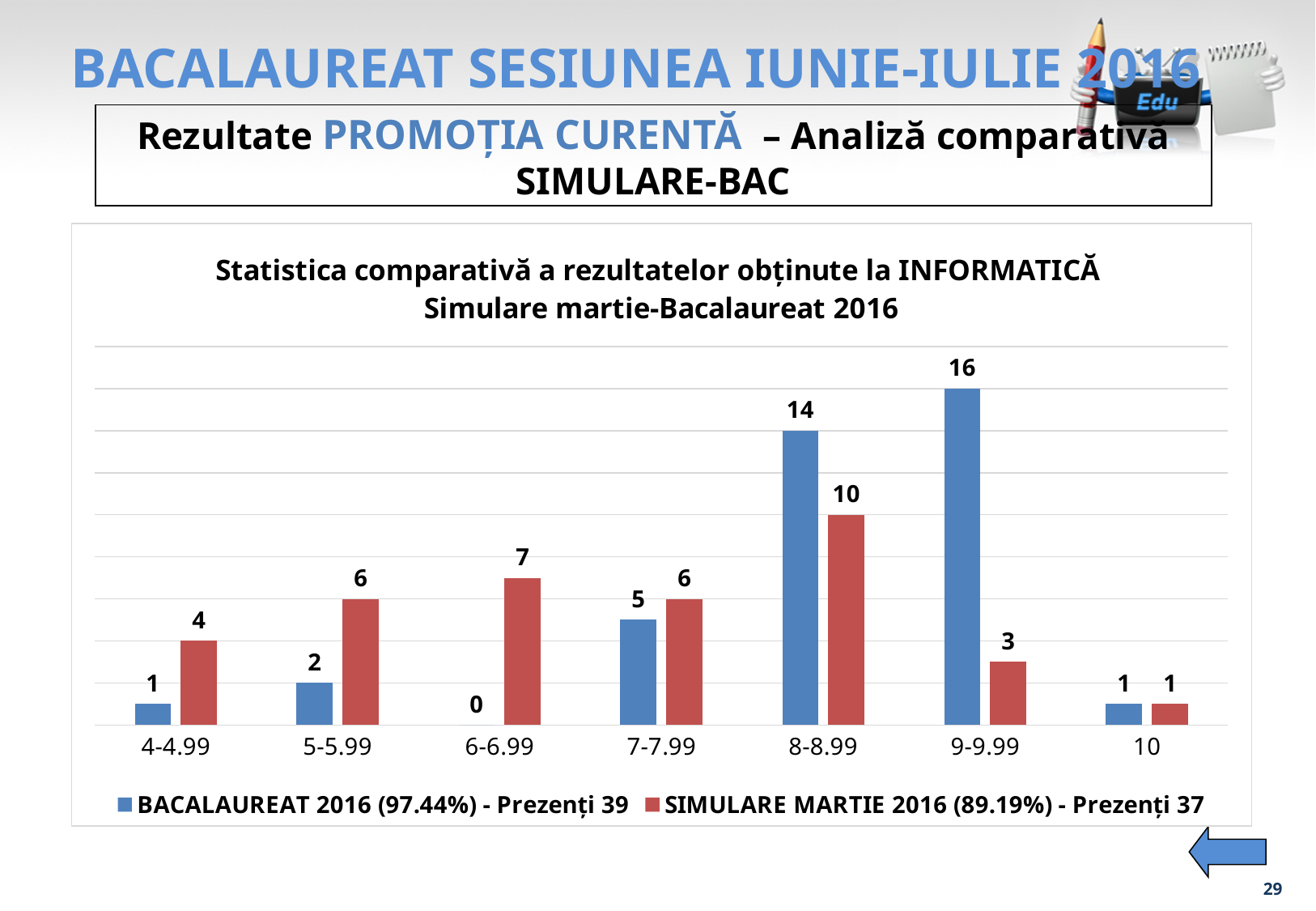
What is the value for SIMULARE MARTIE 2016 in the 10 category? 1 Which category has the highest value for BACALAUREAT 2016? 9-9.99 What is the value for BACALAUREAT 2016 in the 8-8.99 category? 14 What is the value for BACALAUREAT 2016 in the 6-6.99 category? 0 What is the difference between the BACALAUREAT 2016 and SIMULARE MARTIE 2016 values in the 9-9.99 category? 13 What kind of chart is shown on the slide? Bar chart What colour are the bars for the SIMULARE MARTIE 2016 series? Red How many categories are shown on the x axis? 7 Which category has the highest value for SIMULARE MARTIE 2016? 8-8.99 How many series does the legend list? 2 Which series has the larger value in the 5-5.99 category, BACALAUREAT 2016 or SIMULARE MARTIE 2016? SIMULARE MARTIE 2016 What is the value for SIMULARE MARTIE 2016 in the 6-6.99 category? 7